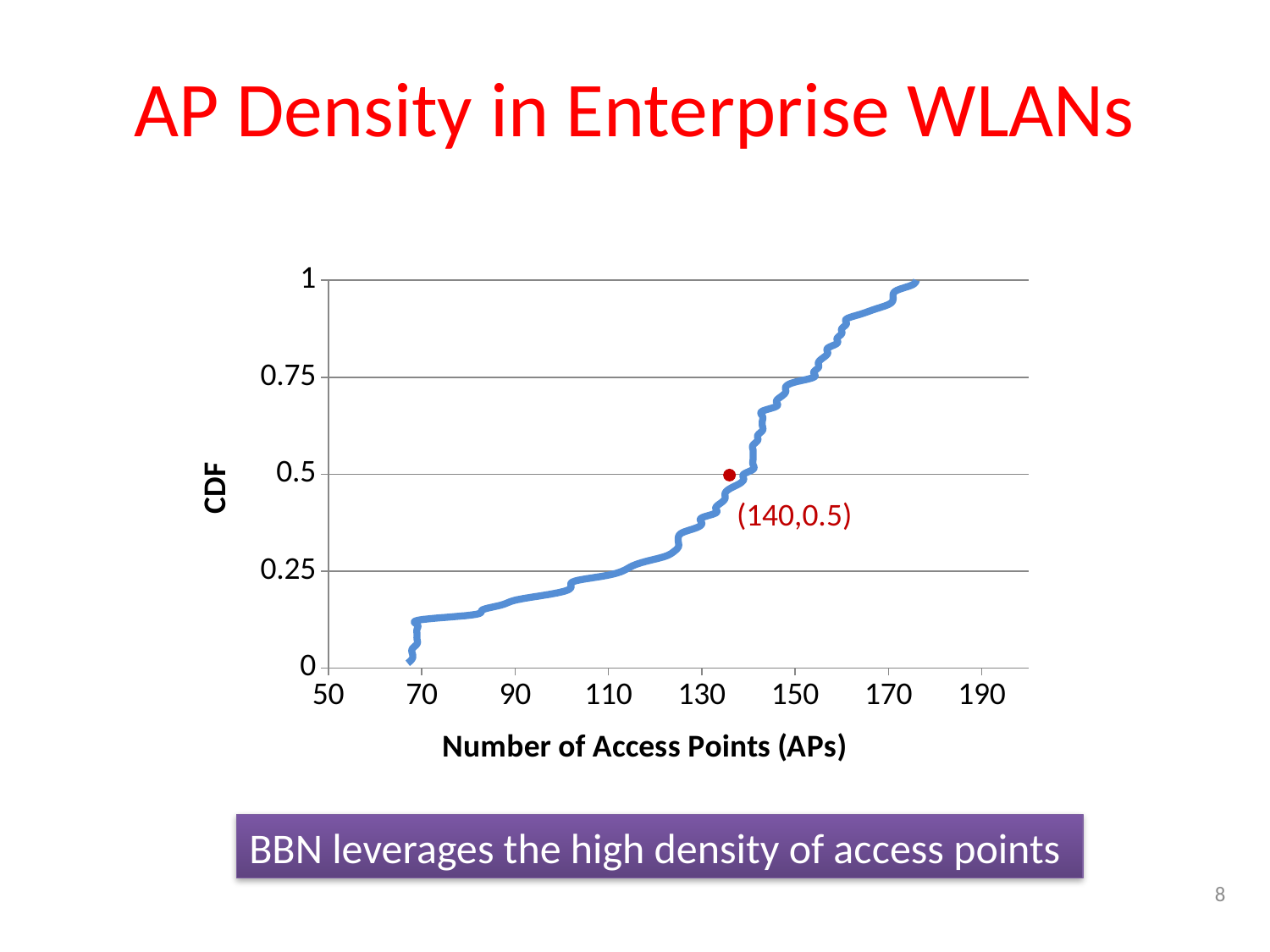
Is the CDF value at 160 access points greater or less than 0.75? greater Does the CDF curve rise or fall as the number of access points increases? rise What kind of chart is shown on the slide? line chart What is the CDF value at the labeled point on the curve? 0.5 Is the CDF value at 90 access points greater or less than 0.25? less What is the label of the x axis? Number of Access Points (APs) What are the coordinates of the labeled point on the curve? (140,0.5) At how many access points does the labeled point on the curve occur? 140 Is the CDF value at 120 access points greater or less than 0.5? less What is the label of the y axis? CDF